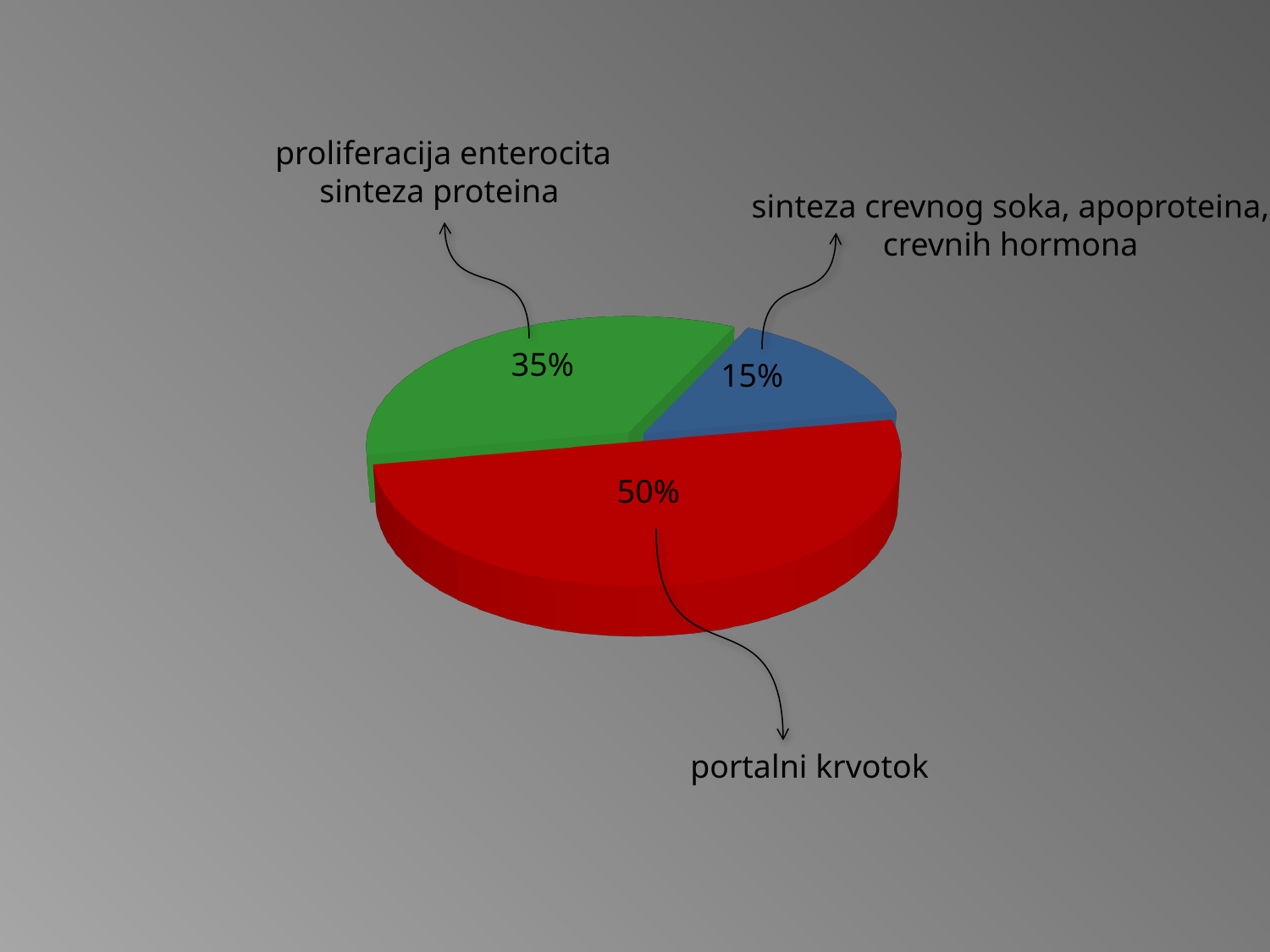
What colour is the 'portalni krvotok' slice? red How many slices does the pie chart have? 3 What colour is the slice labelled 'sinteza crevnog soka, apoproteina, crevnih hormona'? blue What is the difference between the 'proliferacija enterocita sinteza proteina' slice and the 'sinteza crevnog soka, apoproteina, crevnih hormona' slice? 20% What is the difference between the 'portalni krvotok' slice and the 'proliferacija enterocita sinteza proteina' slice? 15% Which is larger: the 'proliferacija enterocita sinteza proteina' slice or the 'sinteza crevnog soka, apoproteina, crevnih hormona' slice? proliferacija enterocita sinteza proteina What kind of chart is shown on the slide? pie chart What percentage is shown for the slice labelled 'sinteza crevnog soka, apoproteina, crevnih hormona'? 15% What percentage is shown for the slice labelled 'portalni krvotok'? 50% Which slice of the pie chart is the smallest? sinteza crevnog soka, apoproteina, crevnih hormona Which slice of the pie chart is the largest? portalni krvotok What percentage is shown for the slice labelled 'proliferacija enterocita sinteza proteina'? 35%